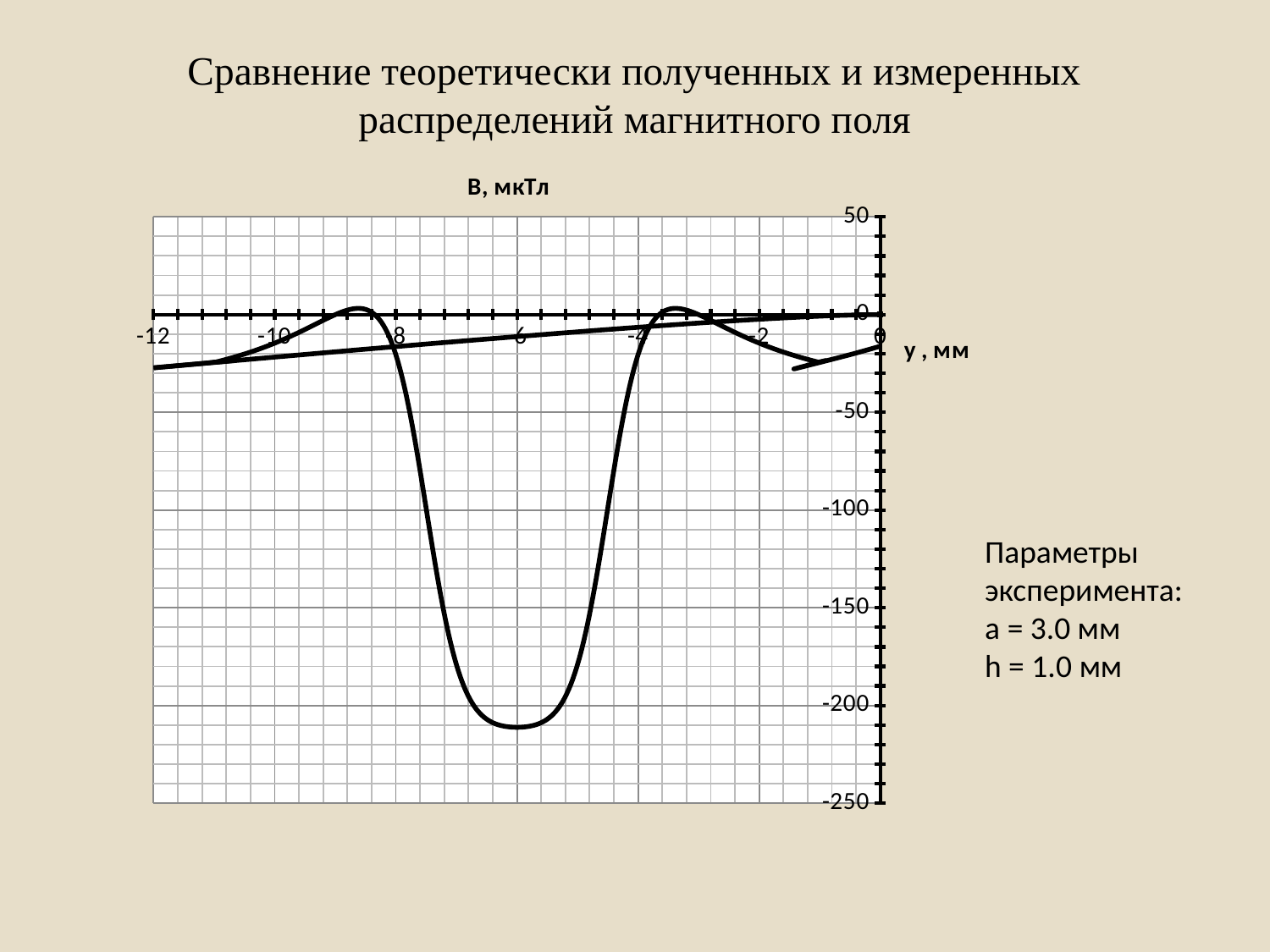
What is the label of the vertical axis of the chart? B, мкТл What is the highest tick value shown on the vertical axis? 50 What is the lowest tick value shown on the vertical axis? -250 At y = -6 mm, is the value of the deeply dipping curve greater or less than -150? less What kind of chart is shown on the slide? line chart What is the label of the horizontal axis of the chart? y , мм At y = -12 mm, is the value of the curve greater or less than -50? greater At y = -6 mm, is the value of the nearly straight curve greater or less than -50? greater How many curves are plotted on the chart? 2 What is the leftmost tick value shown on the horizontal axis? -12